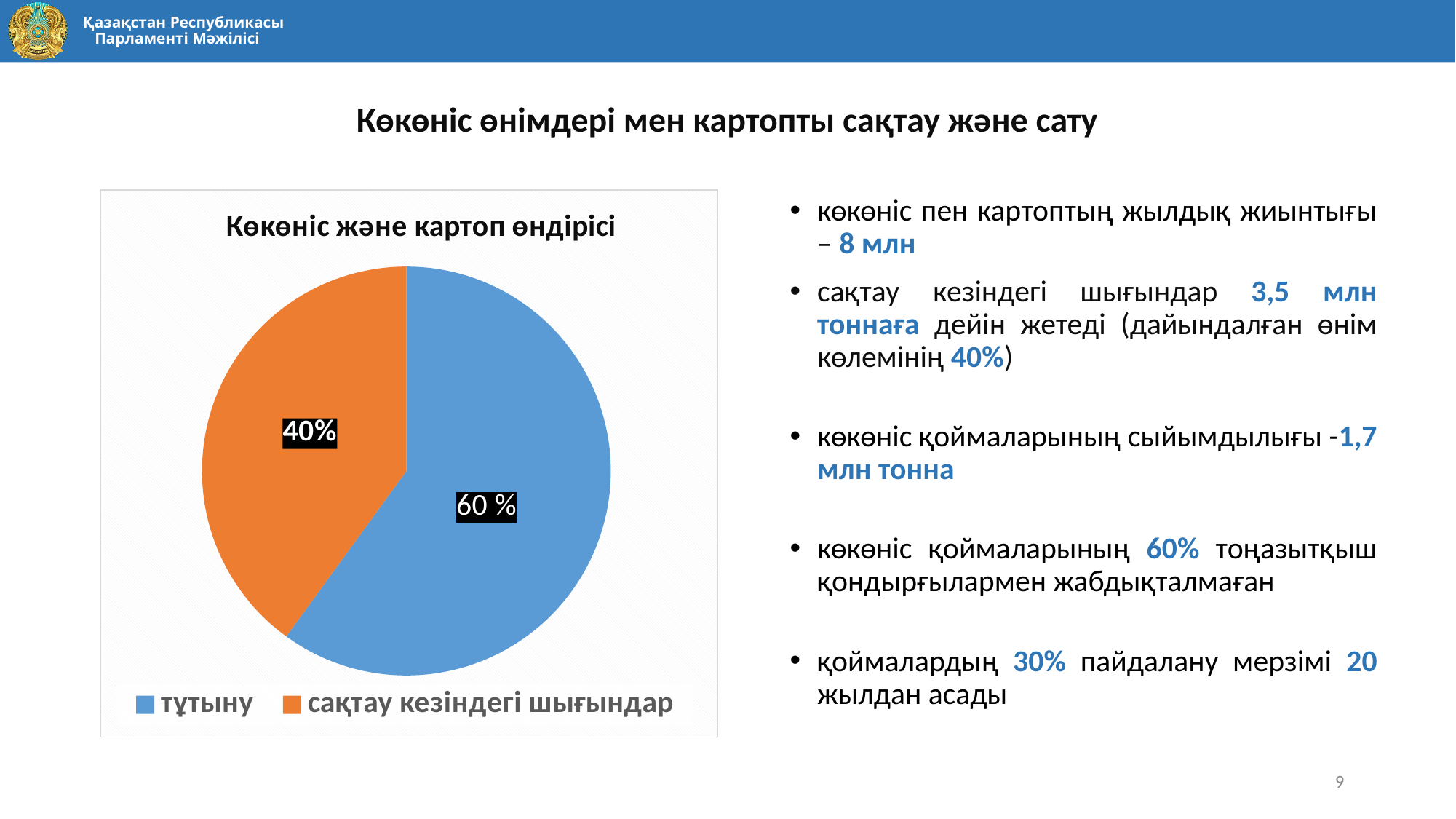
Which is larger, the "тұтыну" slice or the "сақтау кезіндегі шығындар" slice? тұтыну What is the difference in percentage points between the "тұтыну" slice and the "сақтау кезіндегі шығындар" slice? 20 What colour is the "сақтау кезіндегі шығындар" slice? Orange Which slice of the pie chart is the smallest? сақтау кезіндегі шығындар What is the title of the chart? Көкөніс және картоп өндірісі How many entries does the chart legend list? 2 Which slice of the pie chart is the largest? тұтыну What share of the pie does the "тұтыну" slice represent? 60 % How many slices does the pie chart have? 2 What kind of chart is shown on the slide? Pie chart What share of the pie does the "сақтау кезіндегі шығындар" slice represent? 40%